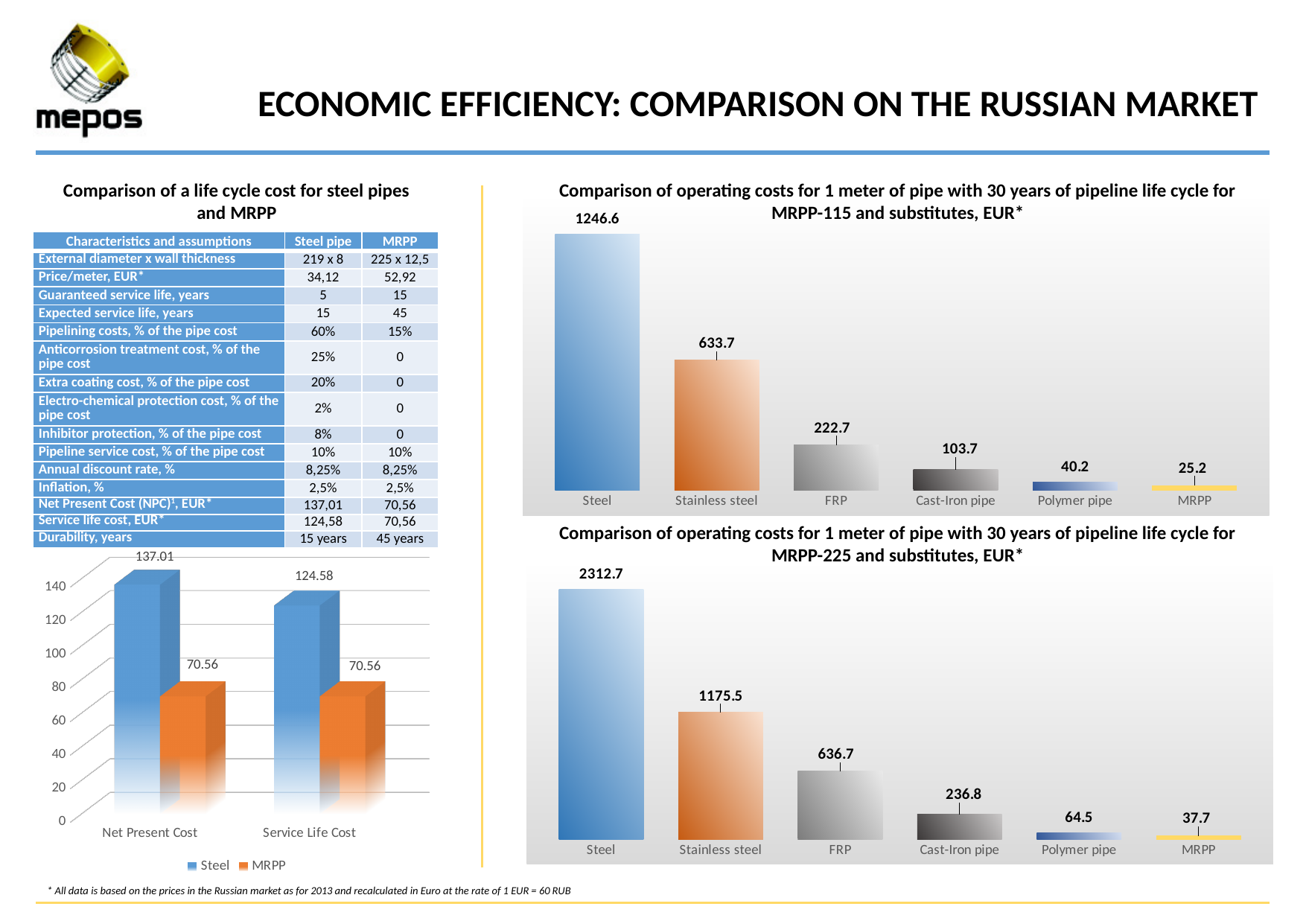
In the bottom-left chart comparing life cycle cost for steel pipes and MRPP, what is the Service Life Cost value for MRPP? 70.56 In the bottom-left chart comparing life cycle cost for steel pipes and MRPP, how many series does the legend list? 2 In the chart of operating costs for MRPP-115 and substitutes, which category has the lowest value? MRPP In the chart of operating costs for MRPP-225 and substitutes, which is larger, the value for FRP or the value for Polymer pipe? FRP In the bottom-left chart comparing life cycle cost for steel pipes and MRPP, what is the Net Present Cost value for Steel? 137.01 What kind of chart is the chart of operating costs for MRPP-225 and substitutes? Bar chart In the chart of operating costs for MRPP-115 and substitutes, what is the difference between the Steel and MRPP values? 1221.4 In the chart of operating costs for MRPP-225 and substitutes, which category has the highest value? Steel In the chart of operating costs for MRPP-115 and substitutes, how many categories are shown? 6 In the chart of operating costs for MRPP-115 and substitutes, what is the value for Stainless steel? 633.7 In the chart of operating costs for MRPP-225 and substitutes, what is the value for Cast-Iron pipe? 236.8 In the bottom-left chart comparing life cycle cost for steel pipes and MRPP, what is the difference between the Steel and MRPP values for Service Life Cost? 54.02